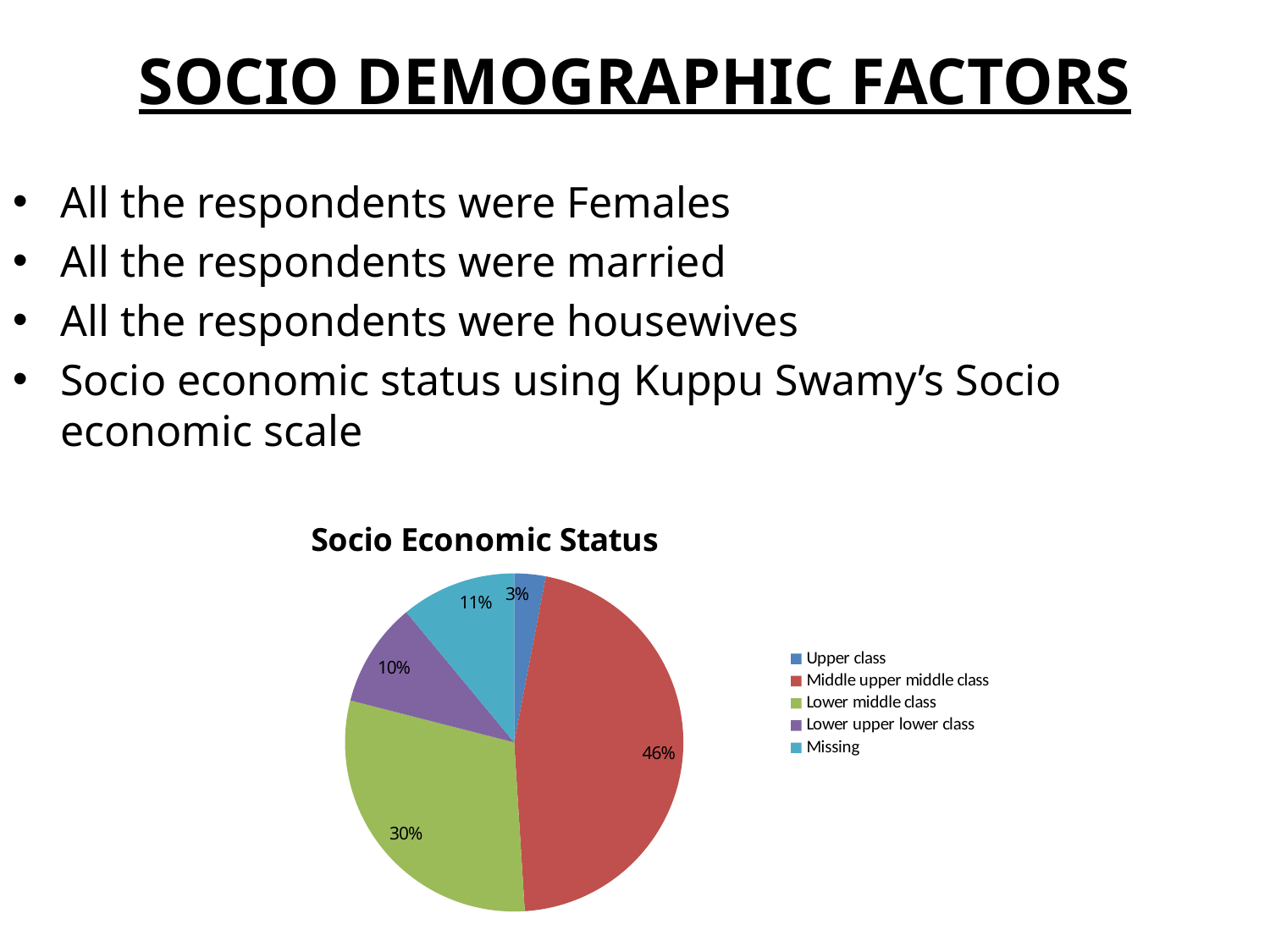
What share of the pie is Upper class? 3% How many categories does the legend list? 5 Which category has the largest slice of the pie? Middle upper middle class What is the title of the chart? Socio Economic Status Which category has the smallest slice of the pie? Upper class Which is larger, the Missing slice or the Upper class slice? Missing What kind of chart is shown on the slide? pie chart What share of the pie is Middle upper middle class? 46% What share of the pie is Lower middle class? 30% What is the difference in percentage points between Middle upper middle class and Lower middle class? 16